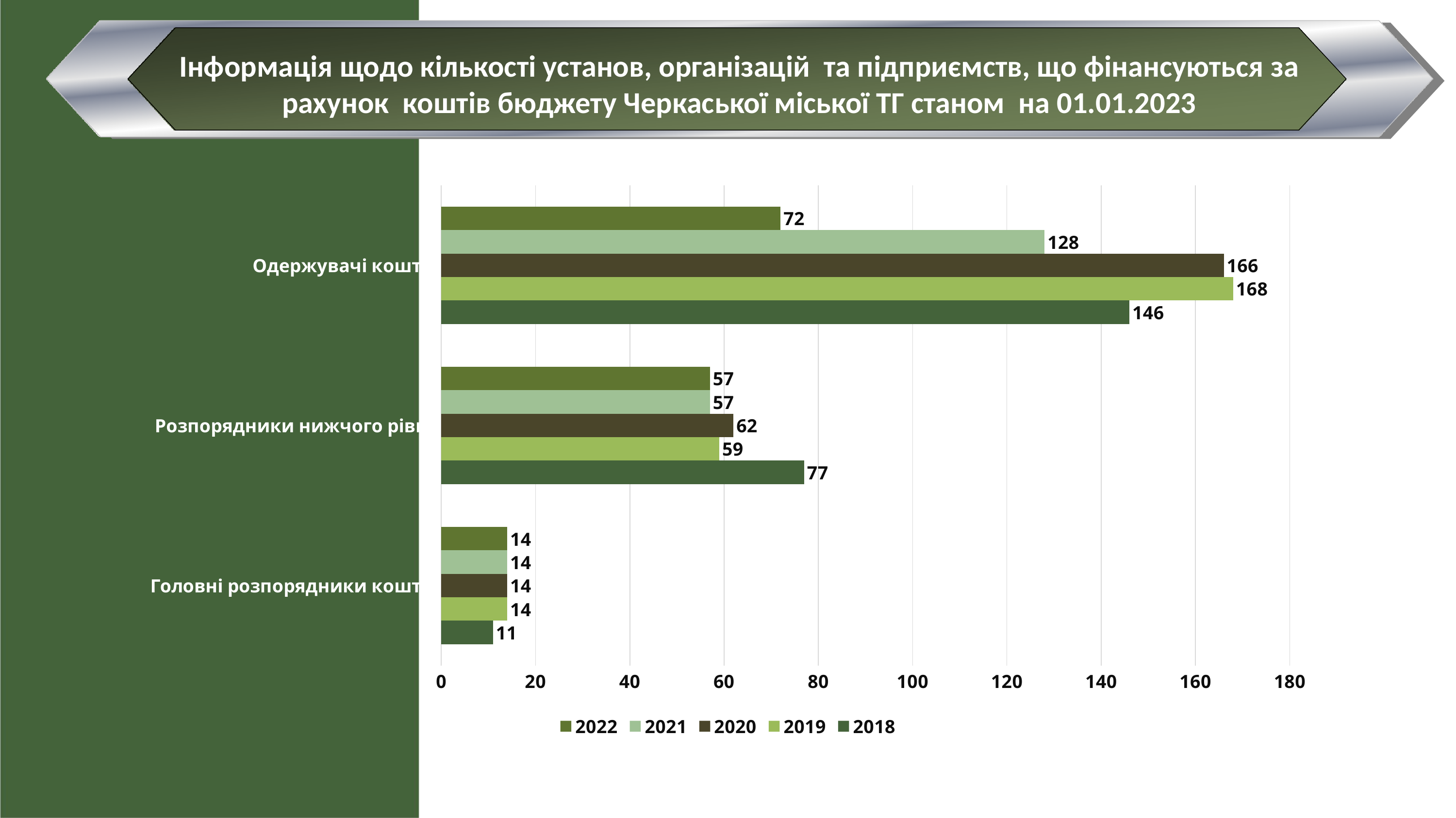
What is the value for 2018 in the middle category (Розпорядники нижчого рівн...)? 77 How many series does the legend list? 5 What is the value for 2019 in the top category (Одержувачі кошт...)? 168 Which series is listed last in the legend? 2018 In the middle category (Розпорядники нижчого рівн...), which is larger: the value for 2018 or the value for 2020? 2018 What is the value for 2018 in the bottom category (Головні розпорядники кошт...)? 11 What kind of chart is shown on the slide? bar chart Which year has the lowest value in the top category (Одержувачі кошт...)? 2022 What is the difference between the 2021 and 2022 values in the top category (Одержувачі кошт...)? 56 Which year has the highest value in the top category (Одержувачі кошт...)? 2019 What is the value for 2022 in the top category (Одержувачі кошт...)? 72 How many categories are shown on the vertical axis of the chart? 3